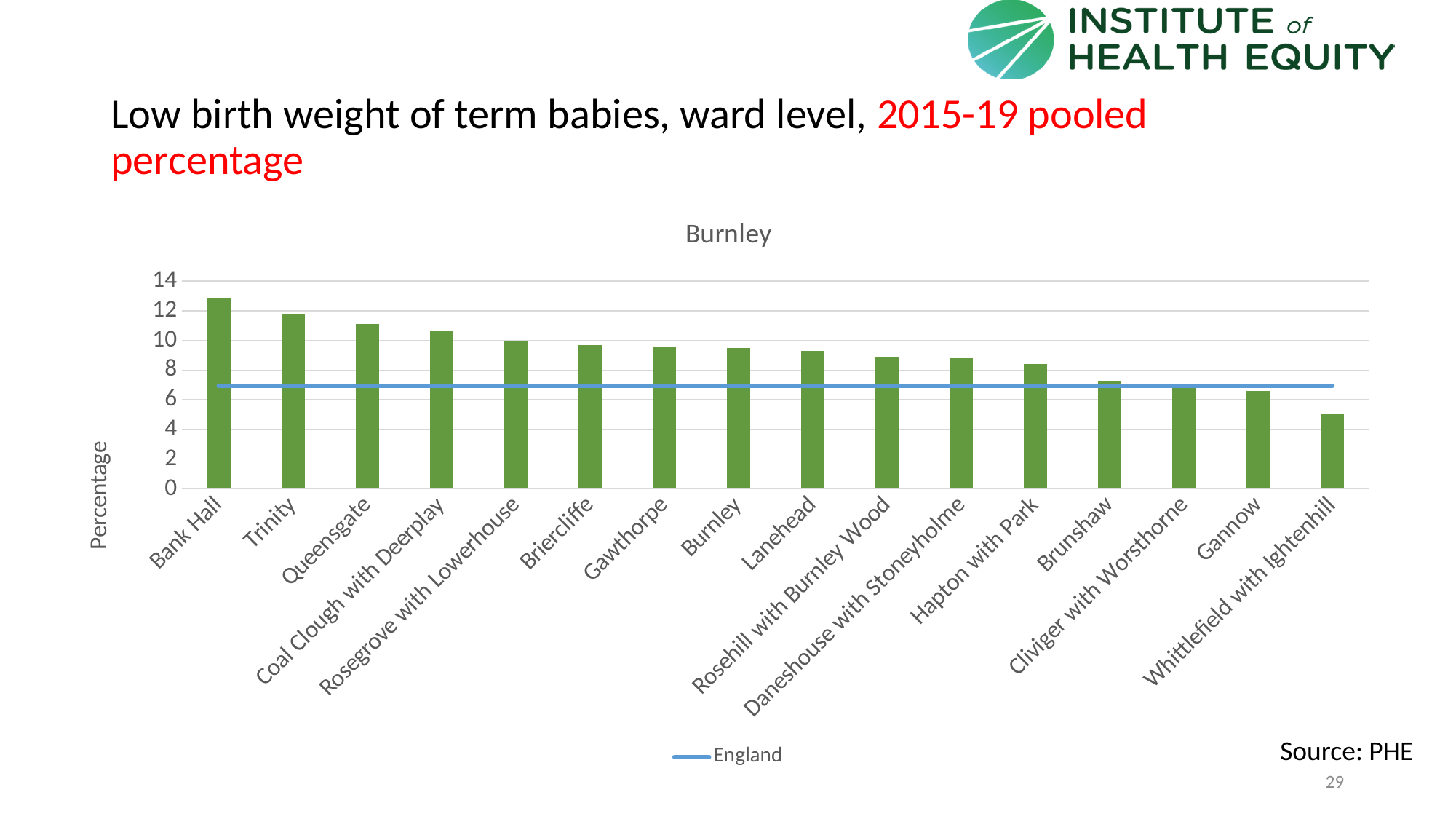
How many wards are plotted on the chart? 16 Which ward has the highest low birth weight percentage? Bank Hall Is the value for Queensgate greater or less than 10? greater Which is larger, the value for Trinity or the value for Brunshaw? Trinity What is the title of the chart? Burnley How many entries does the legend list? 1 Is the value for Bank Hall greater or less than 12? greater Is the value for Gannow greater or less than 8? less What type of chart is shown on the slide? Bar chart with a line (combination bar and line chart) Which ward has the lowest low birth weight percentage? Whittlefield with Ightenhill Do the bar values rise or fall moving from left to right along the x axis? Fall